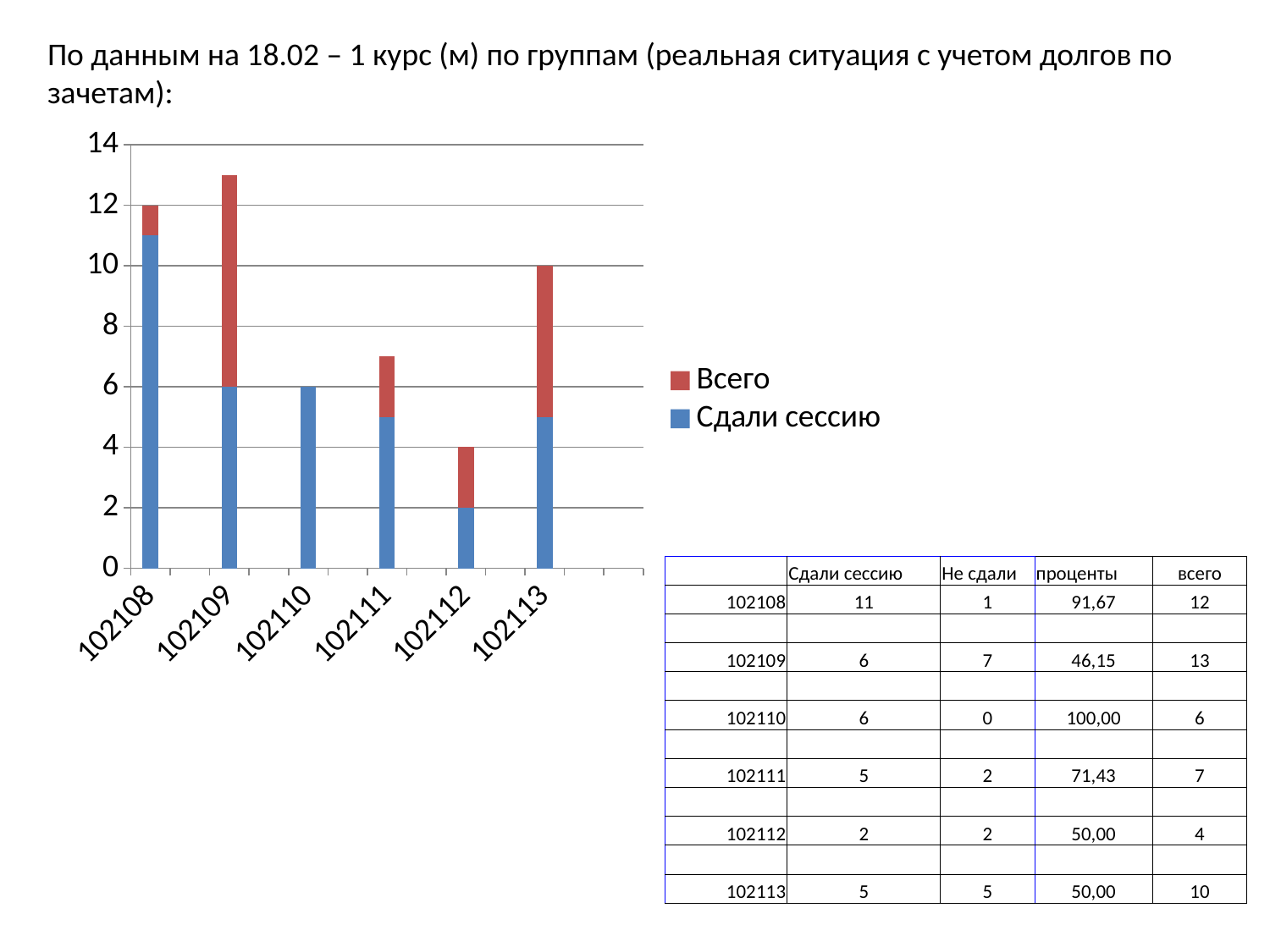
What kind of chart is shown on the slide? bar chart Which is larger: Сдали сессию for group 102108 or Сдали сессию for group 102111? 102108 What is the difference between Всего and Сдали сессию for group 102109? 7 How many groups are shown on the x axis of the chart? 6 Is the value of Всего for group 102111 greater or less than 8? less Which group has the highest value for Всего? 102109 What is the value of Всего for group 102113? 10 How many series does the chart legend list? 2 What are the two series named in the chart legend? Всего and Сдали сессию Which group has the highest value for Сдали сессию? 102108 What is the value of Сдали сессию for group 102108? 11